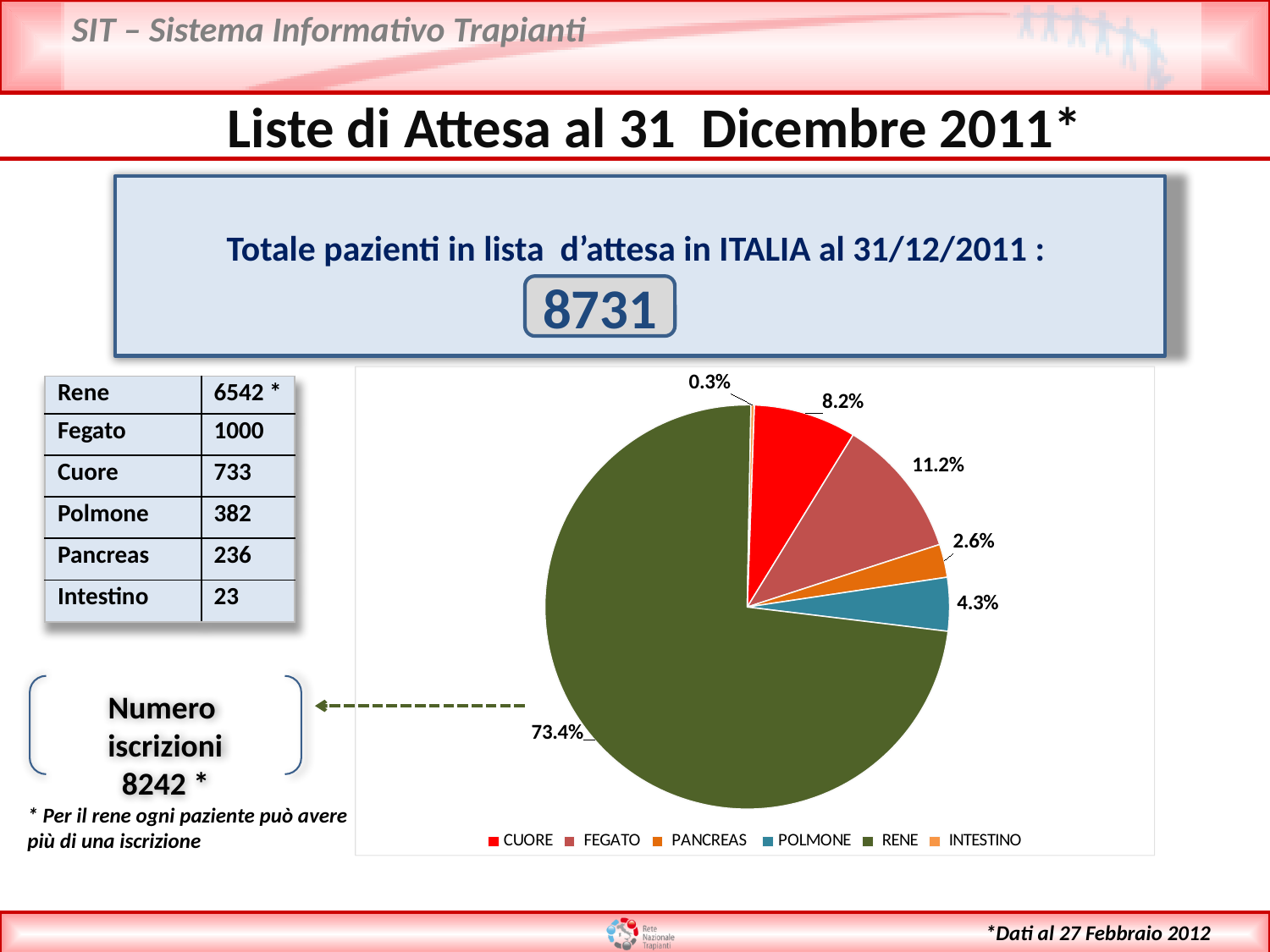
What kind of chart is shown on the slide? pie chart Which category has the smallest slice in the pie chart? INTESTINO What share of the pie chart does CUORE represent? 8.2% Which slice is larger, POLMONE or PANCREAS? POLMONE What share of the pie chart does INTESTINO represent? 0.3% What share of the pie chart does FEGATO represent? 11.2% Which category has the largest slice in the pie chart? RENE What is the difference in percentage points between the FEGATO and CUORE slices? 3.0% How many categories does the legend of the pie chart list? 6